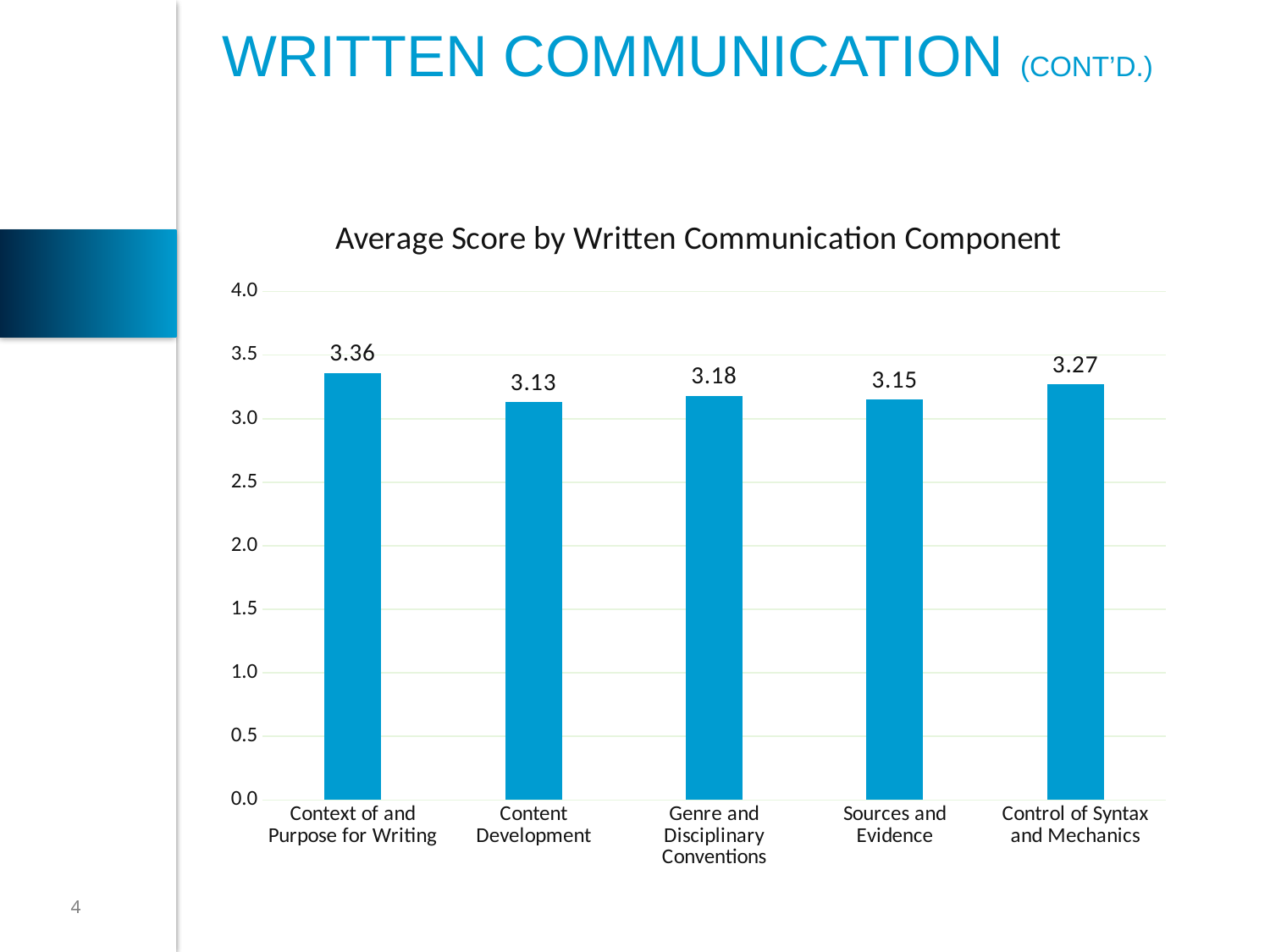
What is the difference between the average scores for Control of Syntax and Mechanics and Sources and Evidence? 0.12 What kind of chart is shown on the slide? Bar chart Which component has the lowest average score? Content Development What is the average score for Context of and Purpose for Writing? 3.36 How many components are shown in the chart? 5 Which component has the highest average score? Context of and Purpose for Writing Which has a higher average score, Genre and Disciplinary Conventions or Control of Syntax and Mechanics? Control of Syntax and Mechanics What is the difference between the average scores for Context of and Purpose for Writing and Content Development? 0.23 What is the average score for Content Development? 3.13 What is the average score for Control of Syntax and Mechanics? 3.27 What is the title of the chart? Average Score by Written Communication Component What is the average score for Genre and Disciplinary Conventions? 3.18